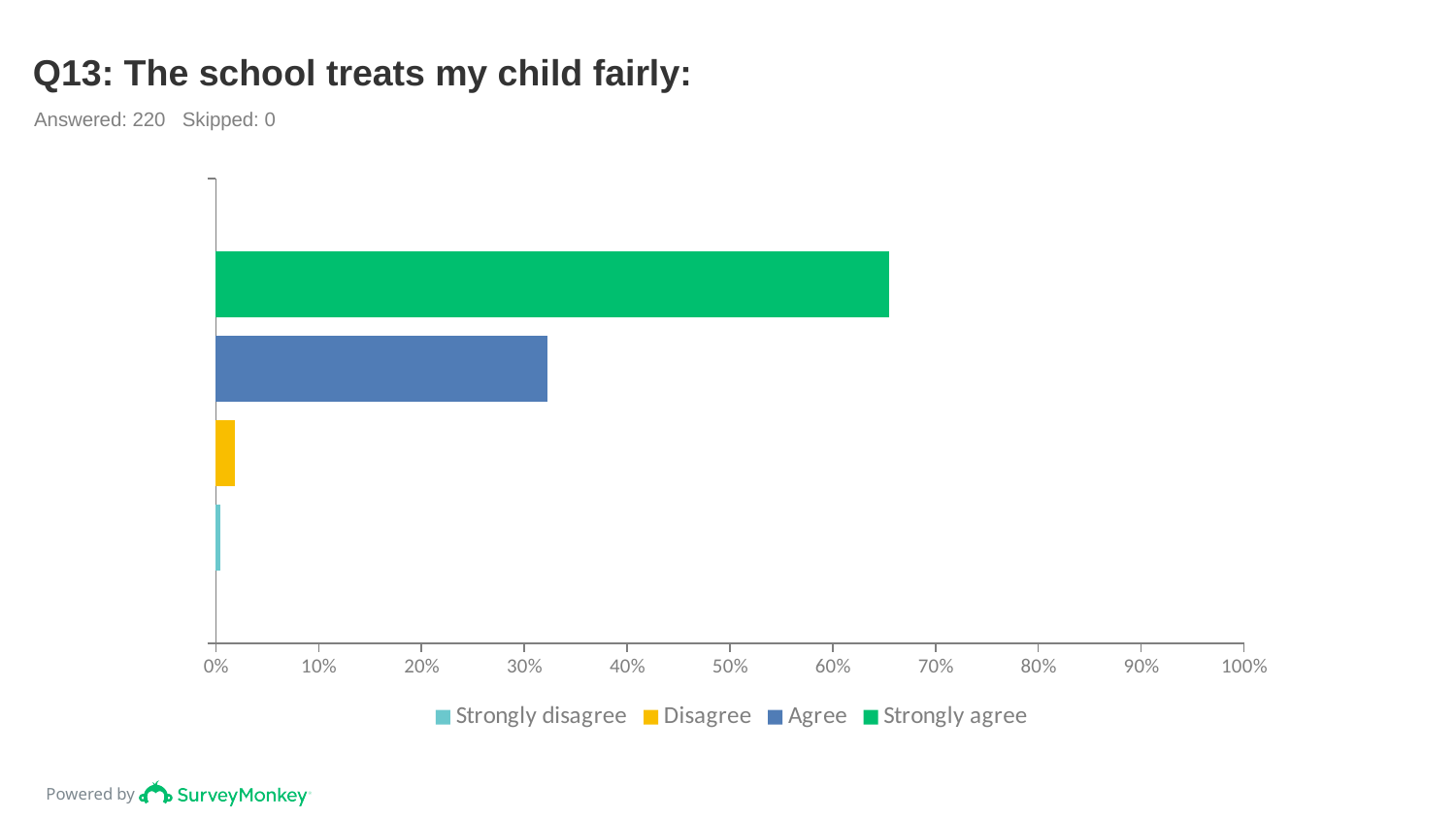
Which is larger, the value for Agree or the value for Strongly agree? Strongly agree Is the value for Disagree greater or less than 10%? less Is the value for Strongly agree greater or less than 60%? greater How many series does the legend list? 4 Is the value for Agree greater or less than 40%? less Which response option has the shortest bar? Strongly disagree Which is larger, the value for Disagree or the value for Agree? Agree Which response option has the longest bar? Strongly agree What is the title of the chart? Q13: The school treats my child fairly: How many respondents answered the question according to the slide? 220 What kind of chart is shown on the slide? bar chart